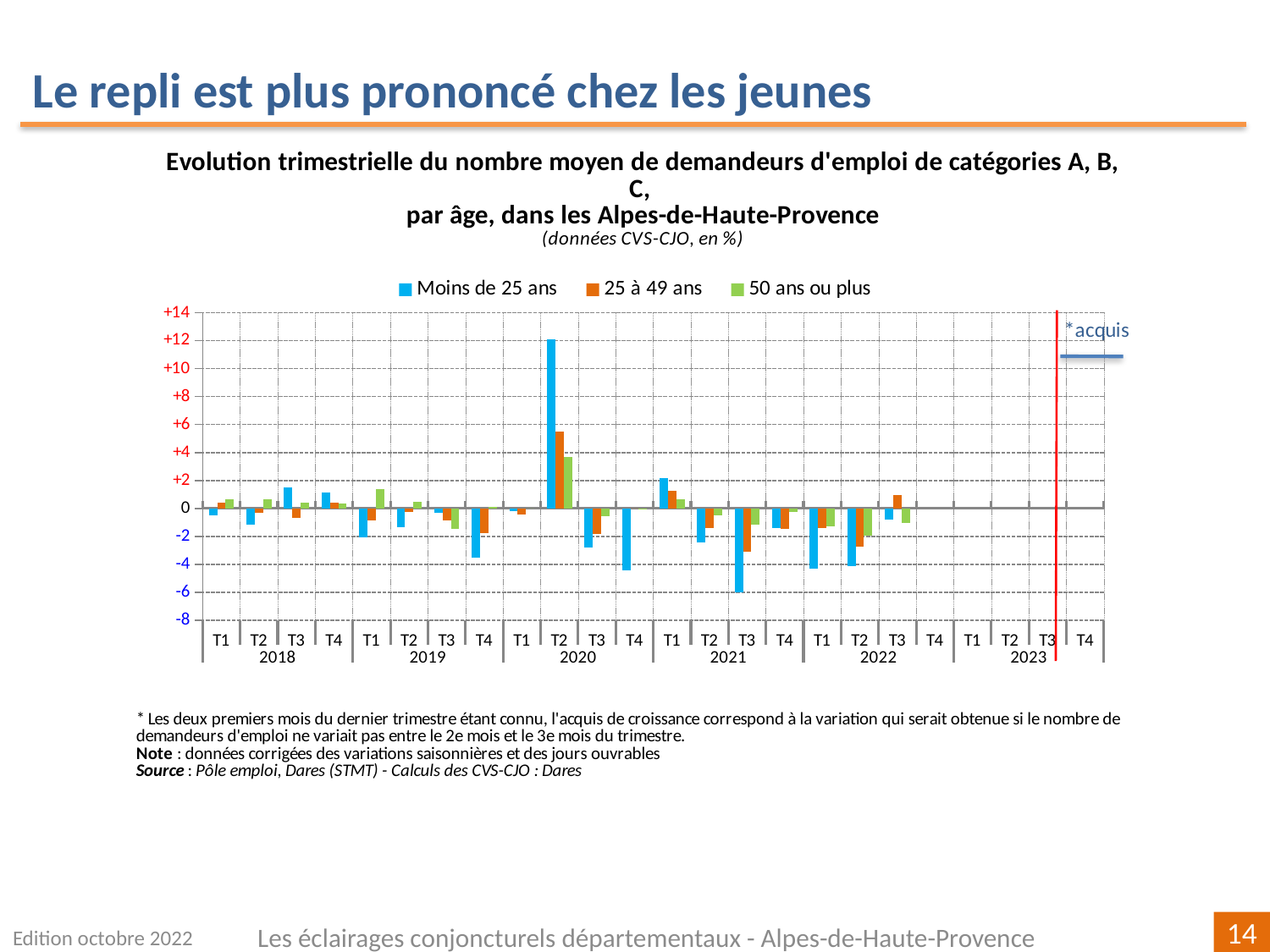
How many years are labelled along the x axis? 6 In which quarter does the 'Moins de 25 ans' series reach its lowest value? T3 2021 What kind of chart is shown on the slide? bar chart Which series is shown in blue in the legend? Moins de 25 ans In T2 2020, which series has the larger value: 'Moins de 25 ans' or '25 à 49 ans'? Moins de 25 ans In which quarter does the 'Moins de 25 ans' series reach its highest value? T2 2020 Is the value for '25 à 49 ans' in T2 2020 greater or less than +4? greater Is the value for 'Moins de 25 ans' in T3 2021 greater or less than -4? less Which series has the largest value in T1 2021? Moins de 25 ans Is the value for 'Moins de 25 ans' in T2 2020 greater or less than +10? greater How many series does the legend list? 3